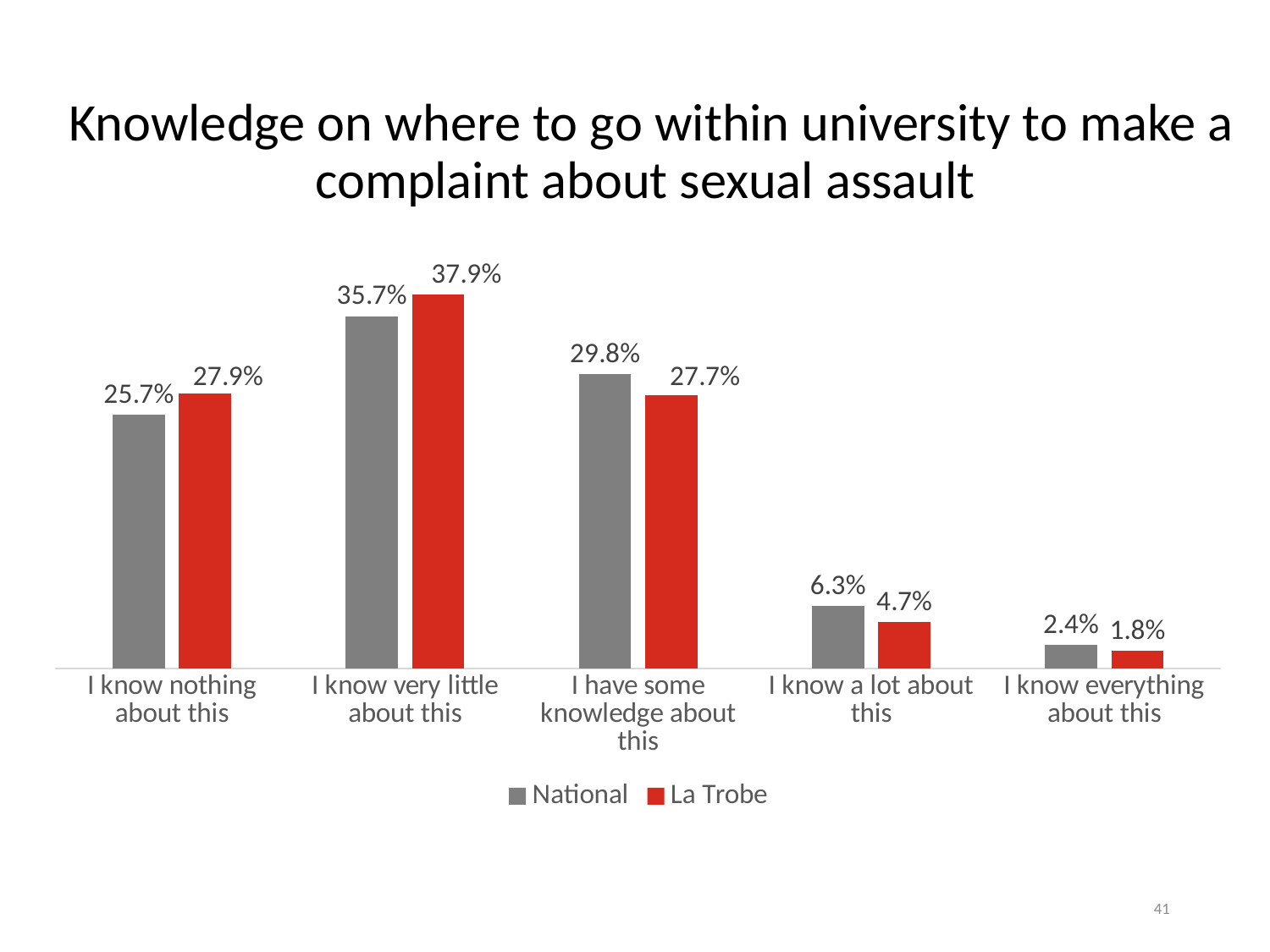
What is the La Trobe value for "I know a lot about this"? 4.7% What is the difference between the La Trobe and National values for "I know very little about this"? 2.2% For "I know a lot about this", which is larger: the National value or the La Trobe value? National How many categories are shown on the x axis? 5 Which category has the highest La Trobe value? I know very little about this What is the difference between the National and La Trobe values for "I have some knowledge about this"? 2.1% What kind of chart is shown on the slide? Bar chart What is the La Trobe value for "I know nothing about this"? 27.9% For "I know nothing about this", which is larger: the National value or the La Trobe value? La Trobe Which category has the lowest National value? I know everything about this How many series does the legend list? 2 What is the National value for "I know very little about this"? 35.7%